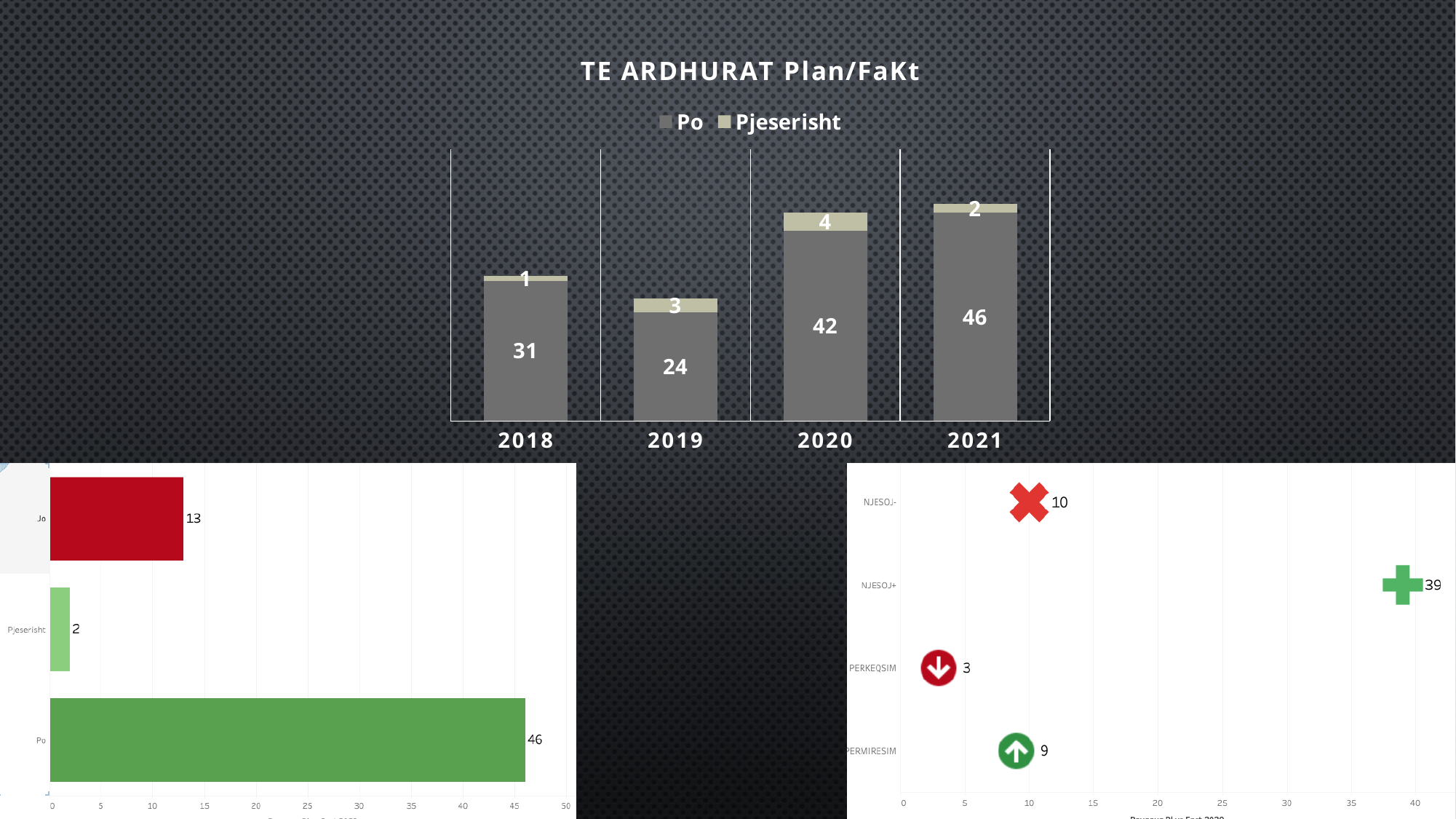
In the top chart titled 'TE ARDHURAT Plan/FaKt', what is the value of the Po series for 2020? 42 How many series does the legend of the top chart titled 'TE ARDHURAT Plan/FaKt' list? 2 In the top chart titled 'TE ARDHURAT Plan/FaKt', what is the value of the Pjeserisht series for 2019? 3 In the bottom-left horizontal bar chart, which category has the highest value? Po How many years are shown on the x axis of the top chart titled 'TE ARDHURAT Plan/FaKt'? 4 In the bottom-left horizontal bar chart, what is the value for Jo? 13 In the bottom-right chart, which category has the lowest value? PERKEQSIM In the bottom-right chart, what is the value for NJESOJ+? 39 In the top chart titled 'TE ARDHURAT Plan/FaKt', what is the difference between the Po values for 2021 and 2018? 15 In the top chart titled 'TE ARDHURAT Plan/FaKt', which year has the highest Po value? 2021 In the top chart titled 'TE ARDHURAT Plan/FaKt', which year has the lowest Po value? 2019 In the top chart titled 'TE ARDHURAT Plan/FaKt', what is the total of the stacked bar for 2020? 46